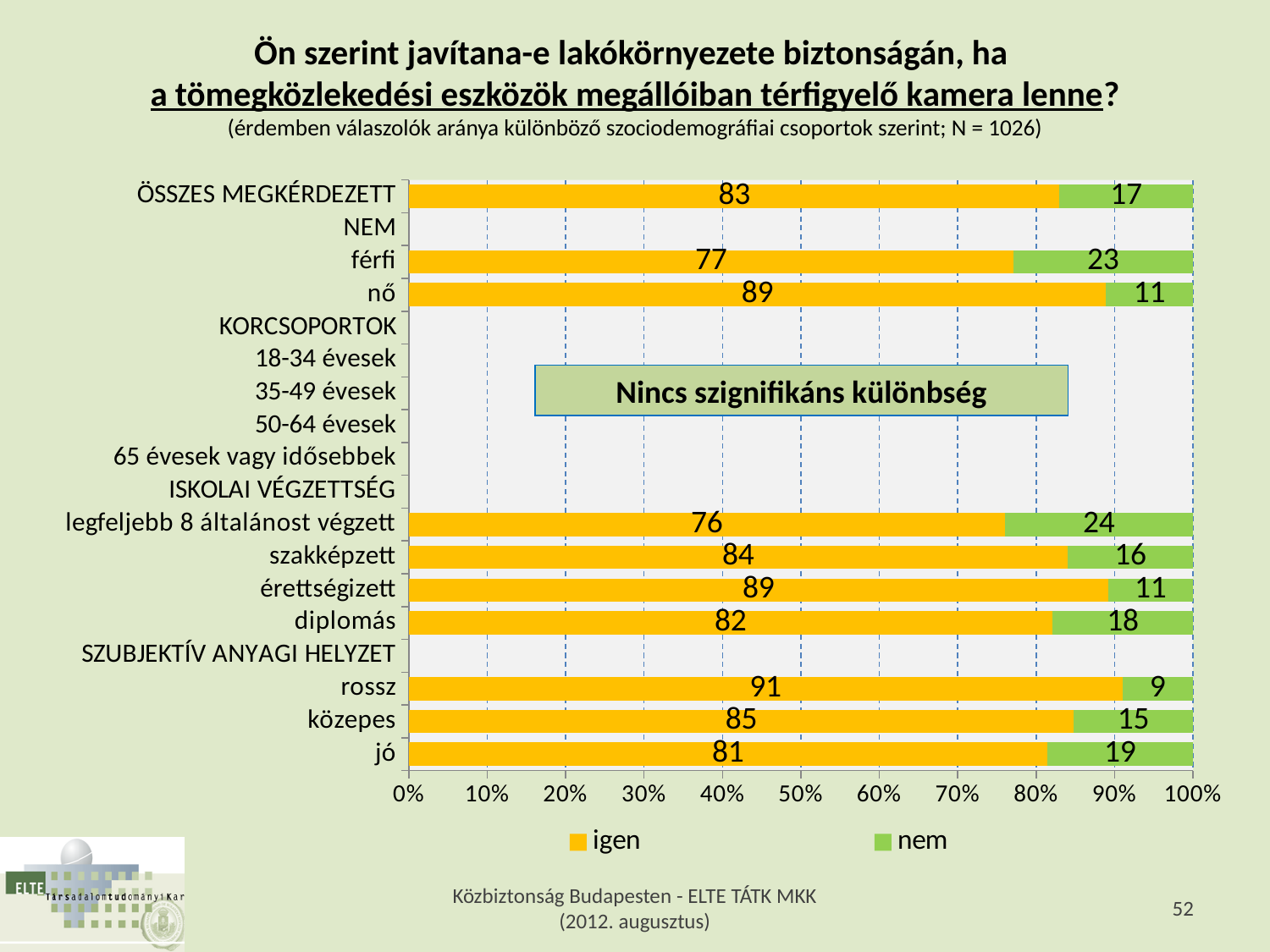
What kind of chart is shown on the slide? stacked bar chart What is the total of the stacked bar for ÖSSZES MEGKÉRDEZETT? 100 Which category has the highest 'igen' value? rossz What is the 'nem' value for diplomás? 18 How many series does the legend list? 2 What is the difference between the 'igen' values for nő and férfi? 12 What is the 'igen' value for férfi? 77 Which category has the lowest 'igen' value? legfeljebb 8 általánost végzett What is the 'nem' value for rossz? 9 What text appears in the box placed over the age-group rows of the chart? Nincs szignifikáns különbség Is the 'igen' value for közepes greater or less than 80%? greater Which has the larger 'igen' value, szakképzett or diplomás? szakképzett